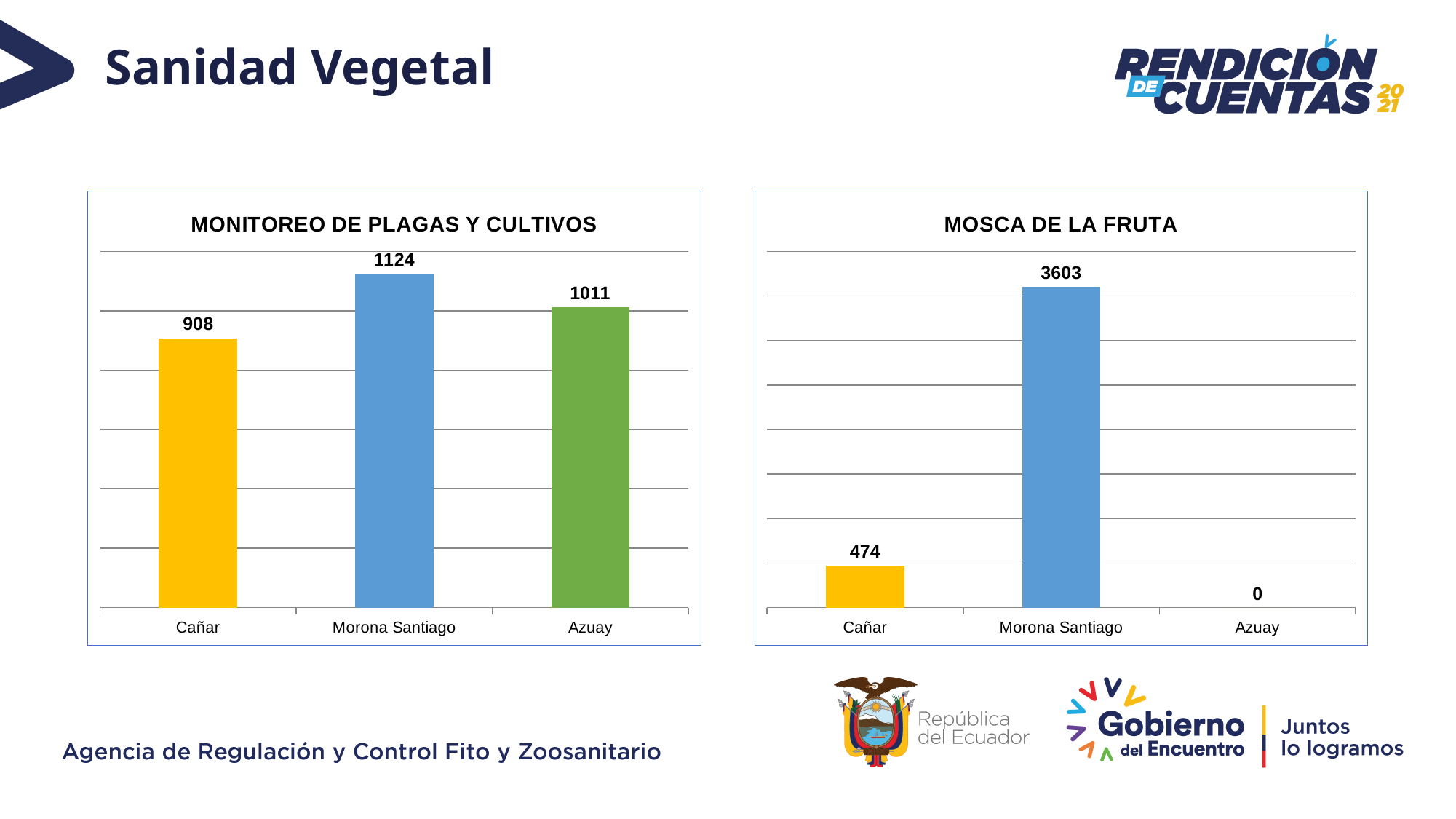
In the MONITOREO DE PLAGAS Y CULTIVOS chart, which category has the lowest value? Cañar In the MONITOREO DE PLAGAS Y CULTIVOS chart, what is the value for Morona Santiago? 1124 In the MOSCA DE LA FRUTA chart, what is the difference between the values for Morona Santiago and Cañar? 3129 How many categories are shown in the MOSCA DE LA FRUTA chart? 3 In the MONITOREO DE PLAGAS Y CULTIVOS chart, which category has the highest value? Morona Santiago In the MOSCA DE LA FRUTA chart, which is larger, the value for Cañar or the value for Azuay? Cañar In the MOSCA DE LA FRUTA chart, what is the value for Morona Santiago? 3603 In the MOSCA DE LA FRUTA chart, what is the value for Azuay? 0 In the MONITOREO DE PLAGAS Y CULTIVOS chart, what is the value for Cañar? 908 In the MONITOREO DE PLAGAS Y CULTIVOS chart, what is the difference between the values for Morona Santiago and Azuay? 113 In the MOSCA DE LA FRUTA chart, which category has the highest value? Morona Santiago What kind of chart is the MONITOREO DE PLAGAS Y CULTIVOS chart? Bar chart